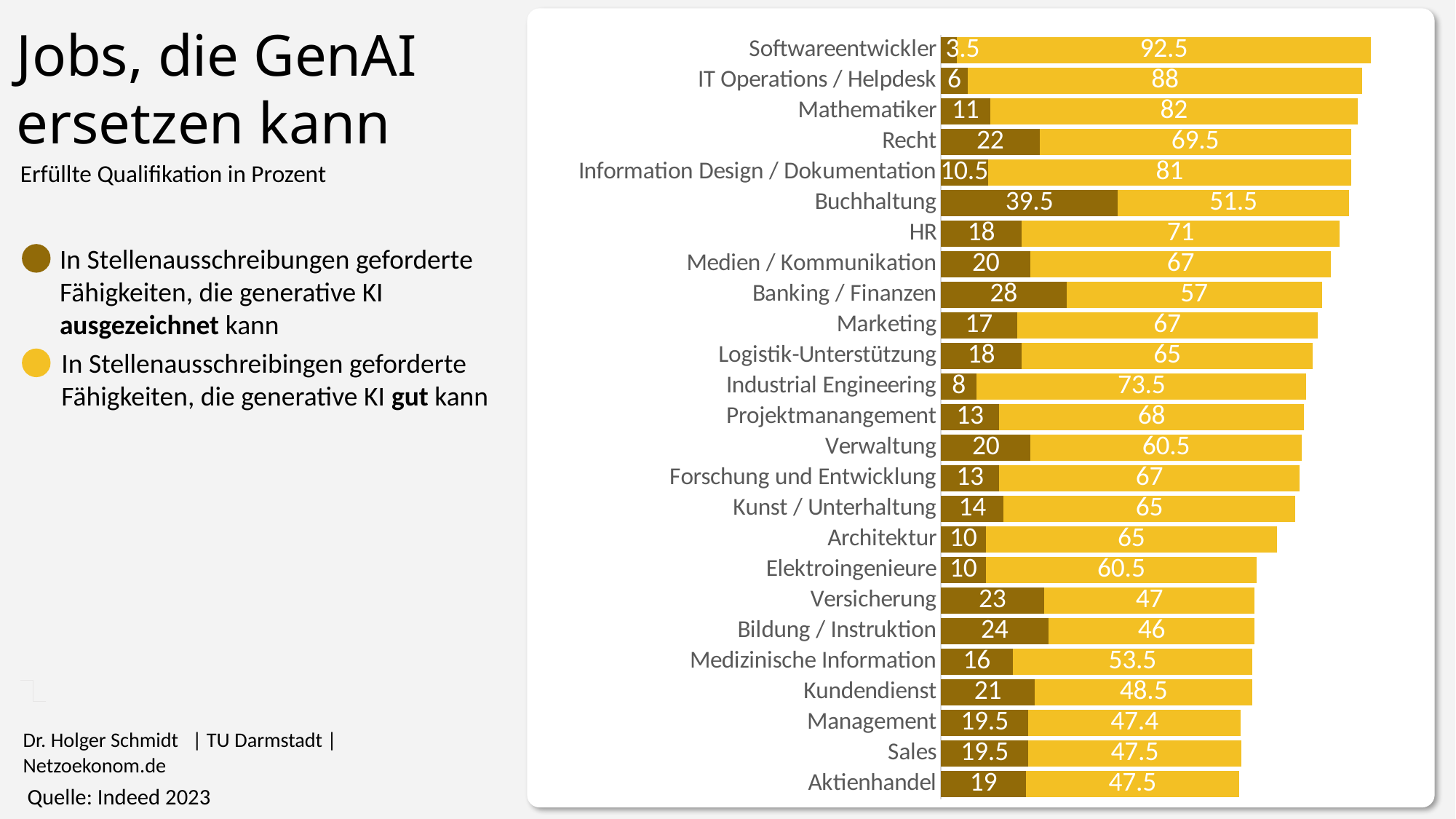
What is the value for Buchhaltung in the series for skills generative AI can do 'ausgezeichnet'? 39.5 What is the total of the stacked bar for Softwareentwickler? 96 What is the difference between the 'gut' value and the 'ausgezeichnet' value for Recht? 47.5 Which job category has the lowest value in the 'ausgezeichnet' series? Softwareentwickler Which job category has the highest value in the 'ausgezeichnet' series? Buchhaltung Which has the larger 'ausgezeichnet' value, Banking / Finanzen or Marketing? Banking / Finanzen What kind of chart is shown on the slide? stacked bar chart What colour represents the series for skills generative AI can do 'gut'? yellow Which job category has the lowest value in the 'gut' series? Bildung / Instruktion How many job categories are plotted in the chart? 25 What is the value for Softwareentwickler in the series for skills generative AI can do 'gut'? 92.5 How many series does the legend list? 2